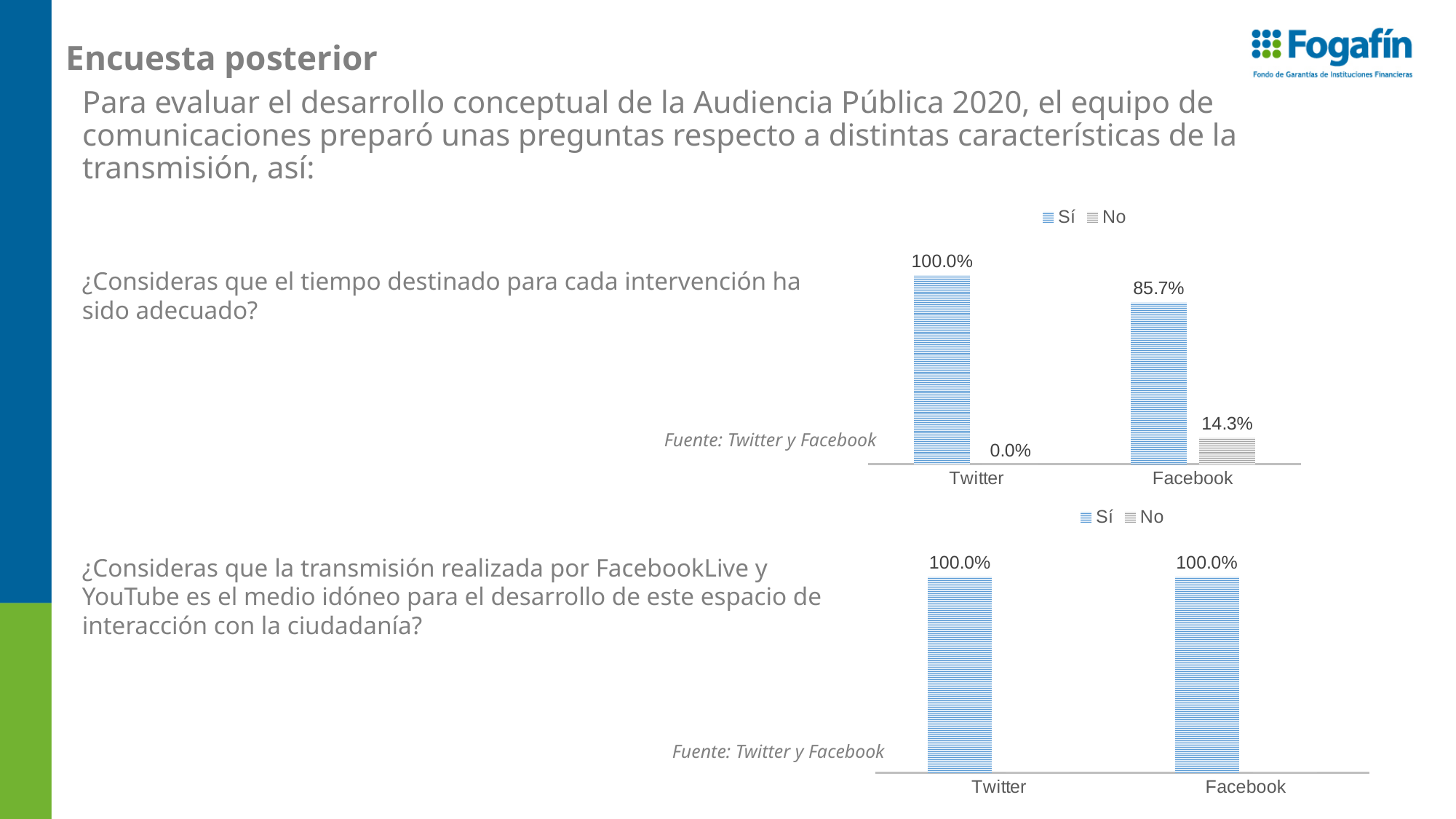
In the bottom chart, what is the value for Sí for Twitter? 100.0% In the top chart, which platform has the lowest No value? Twitter In the top chart, what is the value for No for Facebook? 14.3% In the top chart, how many series does the legend list? 2 In the top chart, what is the value for No for Twitter? 0.0% In the bottom chart, what is the value for Sí for Facebook? 100.0% In the top chart, what is the value for Sí for Twitter? 100.0% What kind of chart is the bottom chart? Bar chart In the top chart, what is the difference between the Sí and No values for Facebook? 71.4% How many categories are shown on the x axis of the top chart? 2 In the top chart, what is the value for Sí for Facebook? 85.7% In the top chart, which platform has the higher Sí value, Twitter or Facebook? Twitter